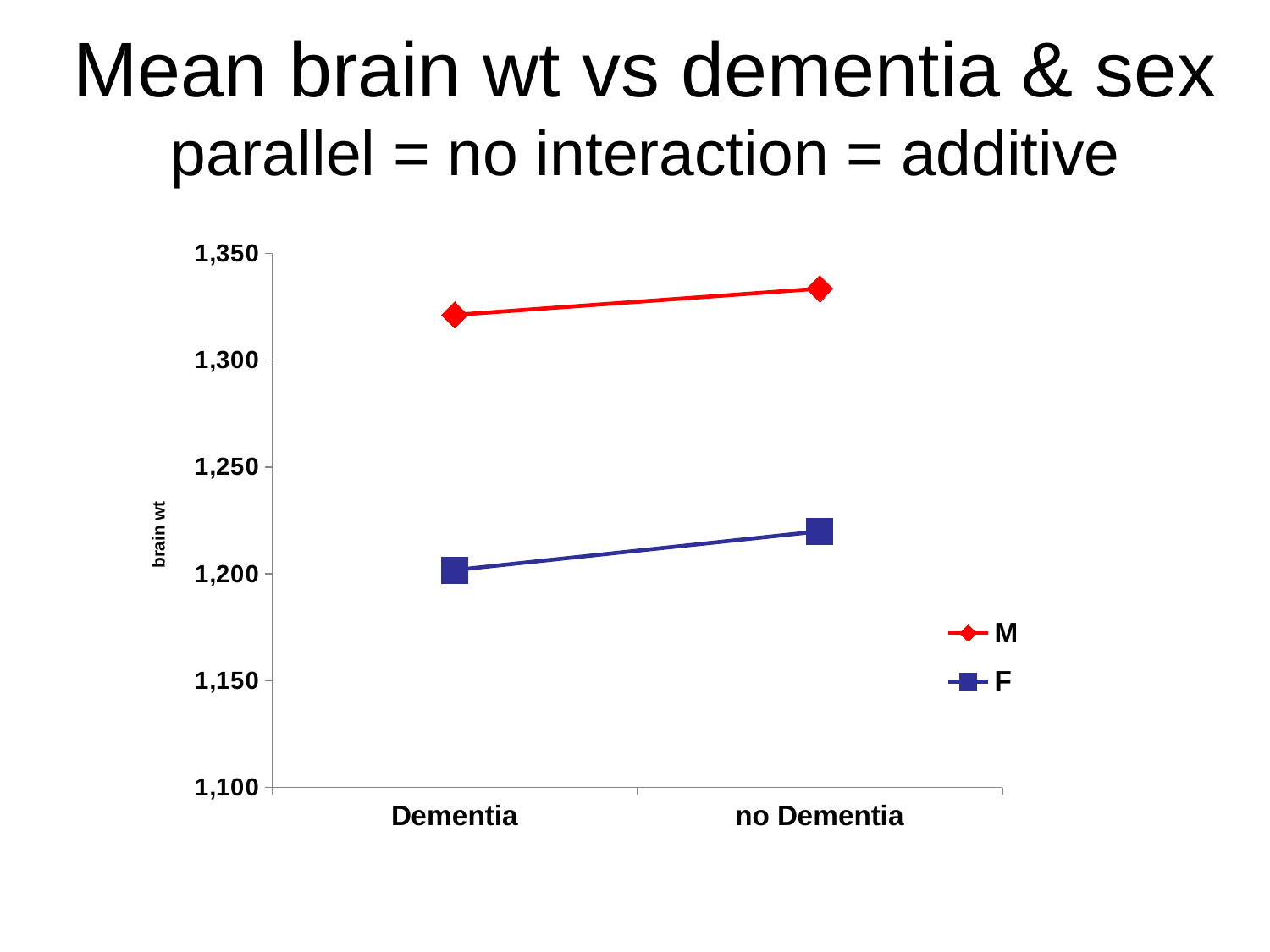
Is the value for M at no Dementia greater or less than 1,350? less Is the value for F at no Dementia greater or less than 1,250? less What kind of chart is shown on the slide? line chart Which series has the higher brain wt for the Dementia category, M or F? M Which series has the lower brain wt for the no Dementia category, M or F? F Which series and category combination has the highest brain wt on the chart? M at no Dementia Does the brain wt for series M rise or fall from Dementia to no Dementia? rise Does the brain wt for series F rise or fall from Dementia to no Dementia? rise How many categories are shown on the x axis? 2 Is the value for M at Dementia greater or less than 1,300? greater How many series does the legend list? 2 What is the label of the y axis? brain wt